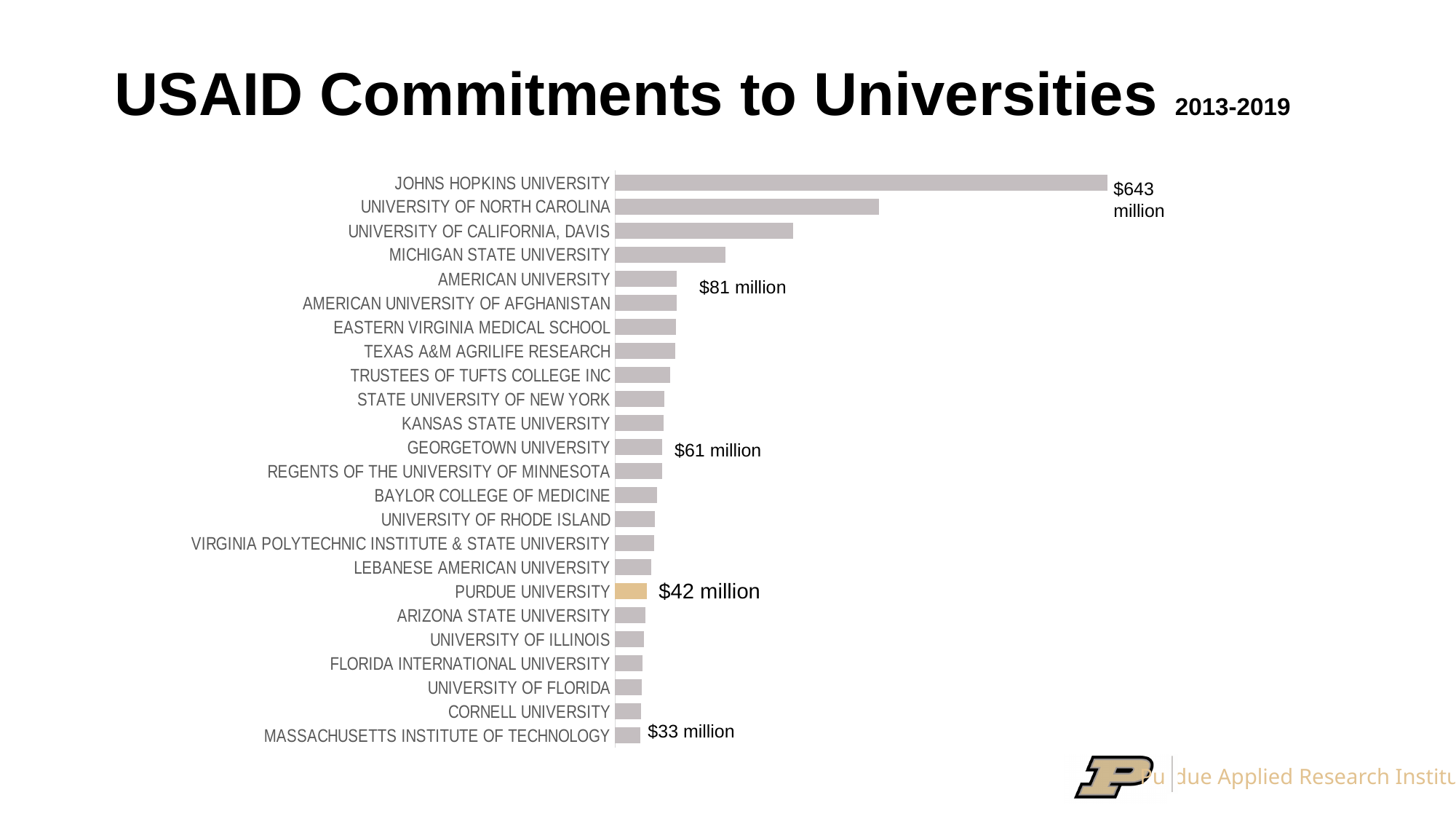
What is the USAID commitment value shown for Purdue University? $42 million What is the USAID commitment value shown for Massachusetts Institute of Technology? $33 million How much larger is the commitment to Johns Hopkins University than to Purdue University? $601 million Which university has the highest USAID commitment in the chart? Johns Hopkins University What is the USAID commitment value shown for American University? $81 million Which received a larger USAID commitment, University of North Carolina or Michigan State University? University of North Carolina What type of chart is shown on the slide? Bar chart What is the USAID commitment value shown for Georgetown University? $61 million What is the USAID commitment value shown for Johns Hopkins University? $643 million Which university has the lowest USAID commitment in the chart? Massachusetts Institute of Technology What is the difference between the commitments to American University and Georgetown University? $20 million How many universities are listed in the chart? 24